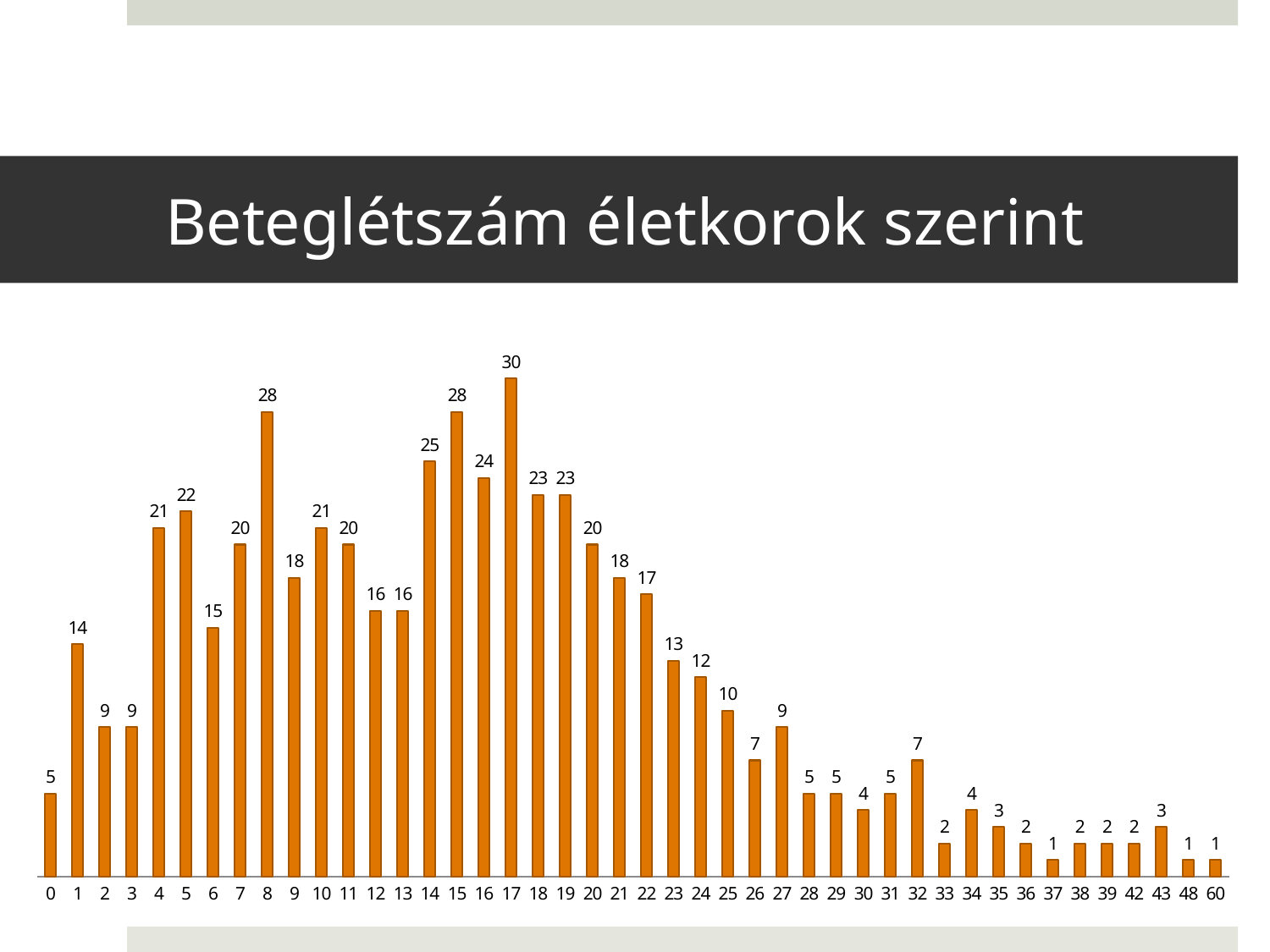
What is the value for age 0? 5 What is the value for age 17? 30 Which age has the highest value? 17 What is the difference between the values for age 14 and age 25? 15 How many age categories are shown on the x axis? 44 What is the difference between the values for age 17 and age 1? 16 Which is larger, the value for age 5 or the value for age 6? age 5 What is the title of the chart? Beteglétszám életkorok szerint What is the value for age 8? 28 What kind of chart is shown on the slide? bar chart What is the lowest value shown on the chart? 1 What is the value for age 60? 1